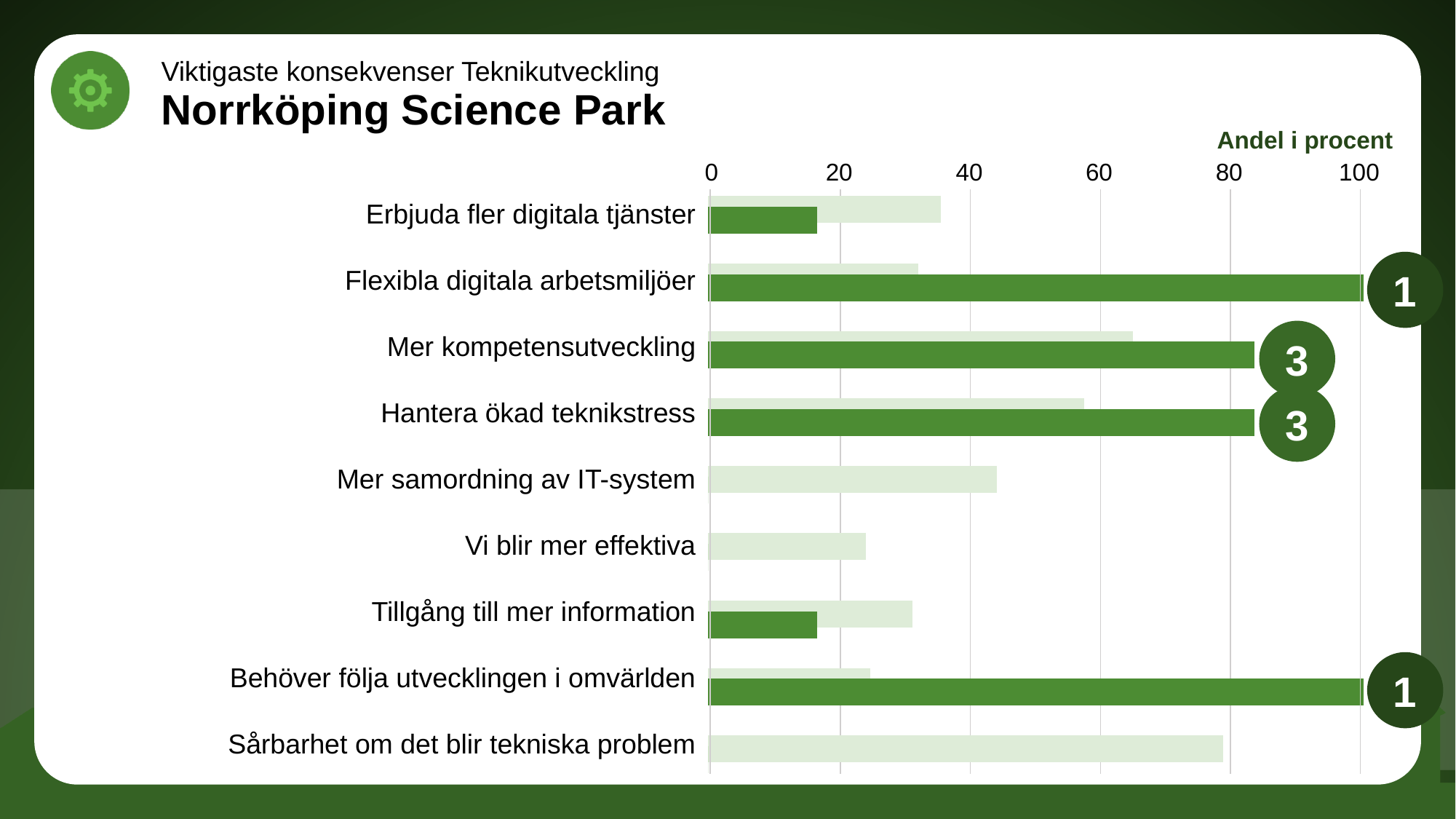
What is the value of the dark green bar for Behöver följa utvecklingen i omvärlden? 100 What kind of chart is shown on the slide? bar chart Is the light green bar for Mer kompetensutveckling greater or less than 60? greater What is the label shown above the horizontal axis of the chart? Andel i procent Is the light green bar for Erbjuda fler digitala tjänster greater or less than 40? less Which has the longer light green bar: Mer samordning av IT-system or Vi blir mer effektiva? Mer samordning av IT-system Which category has the longest light green bar? Sårbarhet om det blir tekniska problem How many categories are listed on the chart? 9 Is the dark green bar for Mer kompetensutveckling greater or less than 80? greater How many categories have a dark green bar? 6 What is the value of the dark green bar for Flexibla digitala arbetsmiljöer? 100